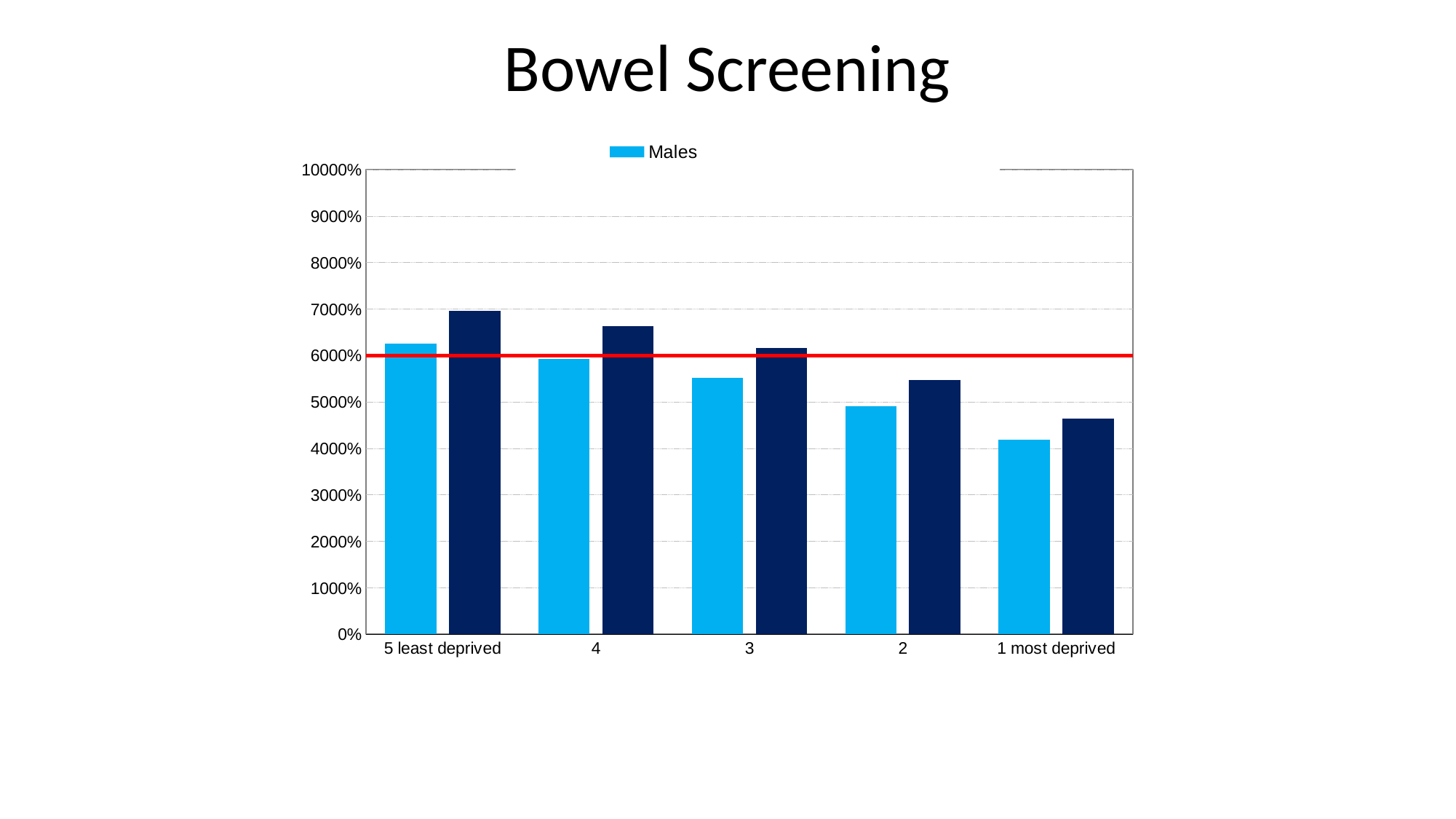
Is the Males value for 1 most deprived greater or less than 5000%? less Which category has the lowest Males value? 1 most deprived Is the Males value for 3 greater or less than 5000%? greater Which category has the highest Males value? 5 least deprived How many categories are shown on the x axis? 5 Is the Males value for 5 least deprived greater or less than 6000%? greater At what value on the y axis is the red horizontal line drawn? 6000% How many series does the legend list? 1 Which is larger, the Males value for 5 least deprived or the Males value for 1 most deprived? 5 least deprived What is the title of the slide? Bowel Screening What kind of chart is shown on the slide? bar chart Do the Males values rise or fall moving from 5 least deprived to 1 most deprived? fall